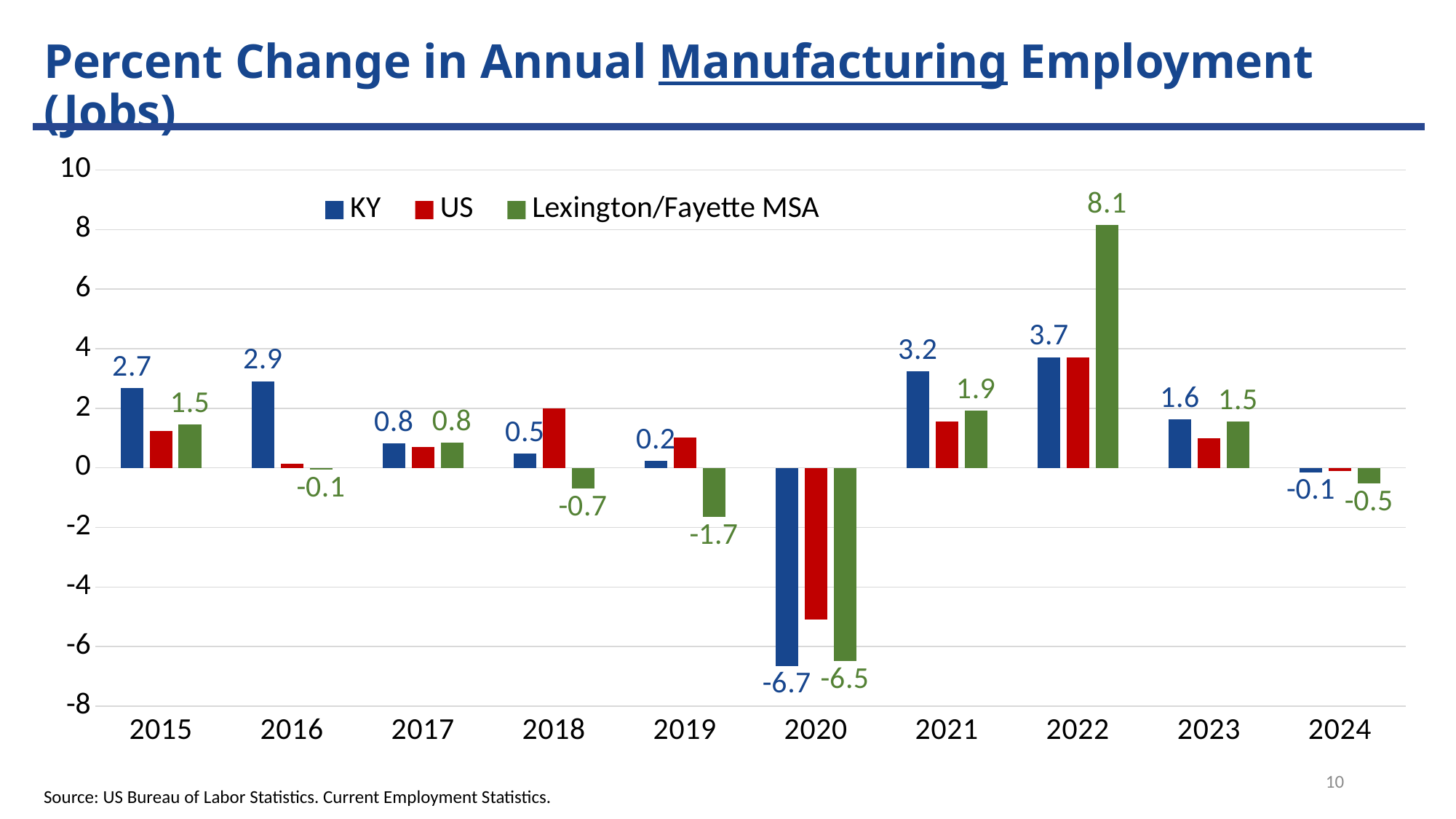
In which year is the Lexington/Fayette MSA value highest? 2022 How many years are shown on the x axis? 10 How many series does the legend list? 3 What is the value for Lexington/Fayette MSA in 2020? -6.5 What is the value for KY in 2019? 0.2 In 2022, which is larger: the KY value or the Lexington/Fayette MSA value? Lexington/Fayette MSA Is the value for US in 2020 greater or less than -4? less What is the difference between the Lexington/Fayette MSA values for 2022 and 2021? 6.2 What is the difference between the KY values for 2016 and 2015? 0.2 In which year is the KY value lowest? 2020 What kind of chart is shown on the slide? bar chart What is the value for KY in 2022? 3.7